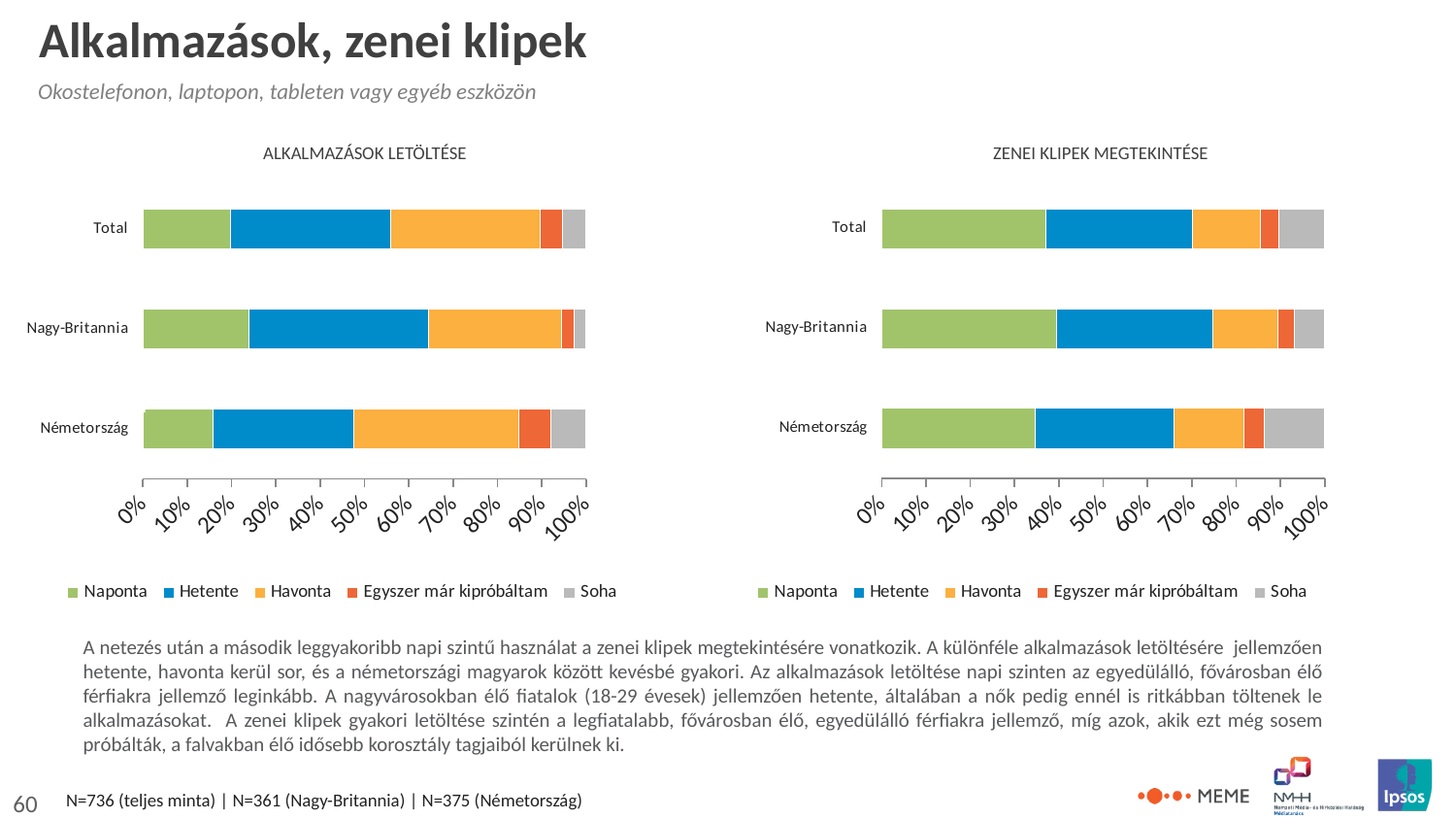
In the 'ZENEI KLIPEK MEGTEKINTÉSE' chart, is the 'Naponta' value for Total greater or less than 30%? greater How many series does the legend of the 'ALKALMAZÁSOK LETÖLTÉSE' chart list? 5 In the 'ZENEI KLIPEK MEGTEKINTÉSE' chart, is the 'Soha' value for Németország greater or less than 10%? greater How many categories are shown on the y axis of the 'ZENEI KLIPEK MEGTEKINTÉSE' chart on the right? 3 What is the title of the chart on the right side of the slide? ZENEI KLIPEK MEGTEKINTÉSE In the 'ALKALMAZÁSOK LETÖLTÉSE' chart, is the 'Naponta' value for Németország greater or less than 20%? less In the 'ALKALMAZÁSOK LETÖLTÉSE' chart, which legend entry is shown in grey? Soha What kind of chart is the 'ALKALMAZÁSOK LETÖLTÉSE' chart on the left? Stacked bar chart In the 'ALKALMAZÁSOK LETÖLTÉSE' chart, which category has the largest 'Naponta' segment? Nagy-Britannia In the 'ALKALMAZÁSOK LETÖLTÉSE' chart, which has the larger 'Naponta' share: Nagy-Britannia or Németország? Nagy-Britannia In the 'ZENEI KLIPEK MEGTEKINTÉSE' chart, which has the larger 'Soha' share: Nagy-Britannia or Németország? Németország